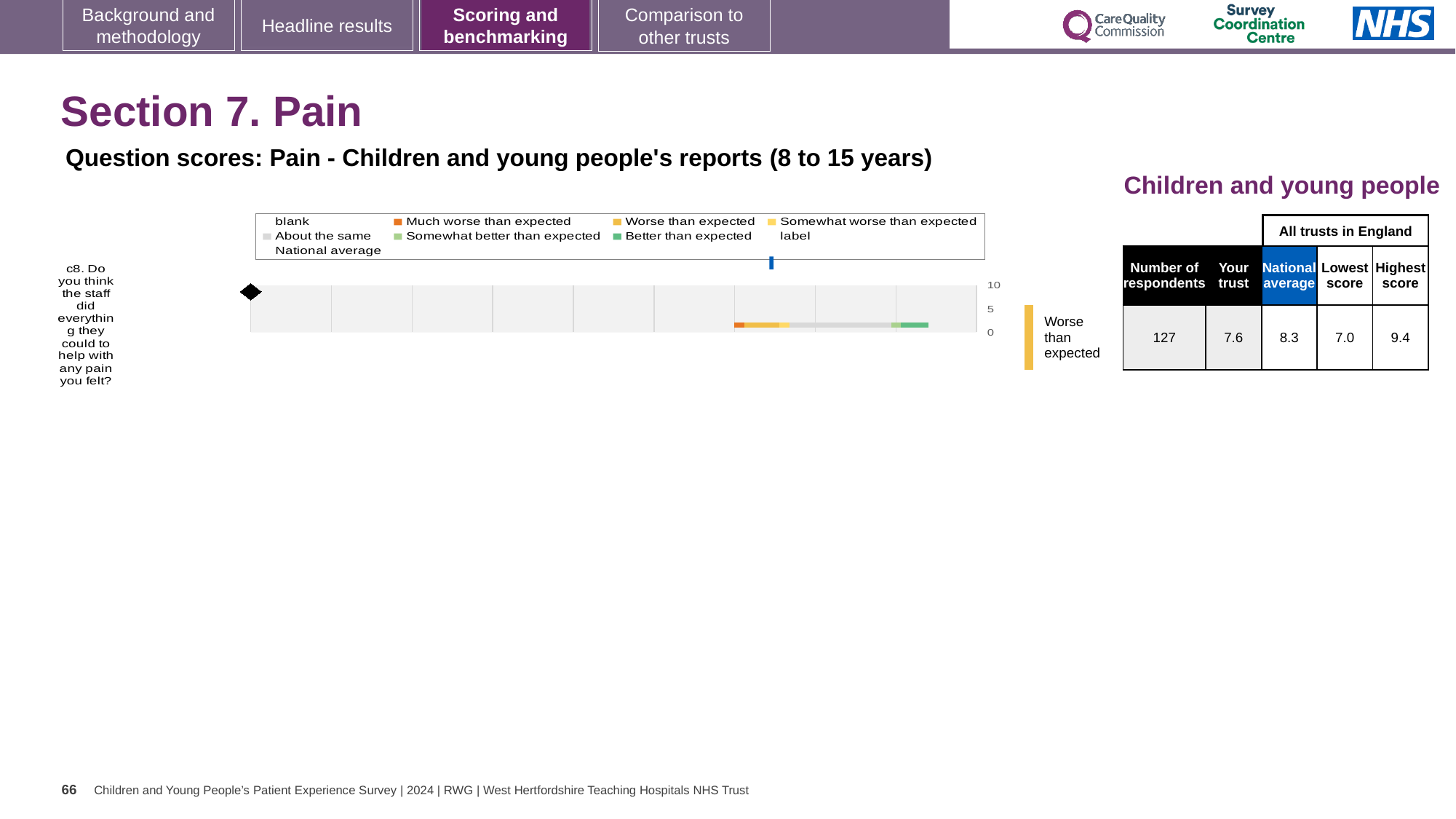
How many survey questions are plotted in the chart on this slide? 1 What is the highest score among all trusts in England shown in the table for question c8? 9.4 By how much does the national average exceed the 'Your trust' score for question c8? 0.7 Which age group of children and young people's reports does the chart on this slide cover? 8 to 15 years How many respondents are listed in the table for question c8? 127 What is the lowest score among all trusts in England shown in the table for question c8? 7.0 What benchmarking category label is shown next to the chart for question c8? Worse than expected What is the national average score shown in the table for question c8? 8.3 What kind of chart is used to show the question score on this slide? Bar chart According to the table on the slide, what is the 'Your trust' score for question c8 about staff helping with pain? 7.6 Which is larger for question c8: the 'Your trust' score or the national average? National average What is the difference between the highest score and the lowest score in the table for question c8? 2.4